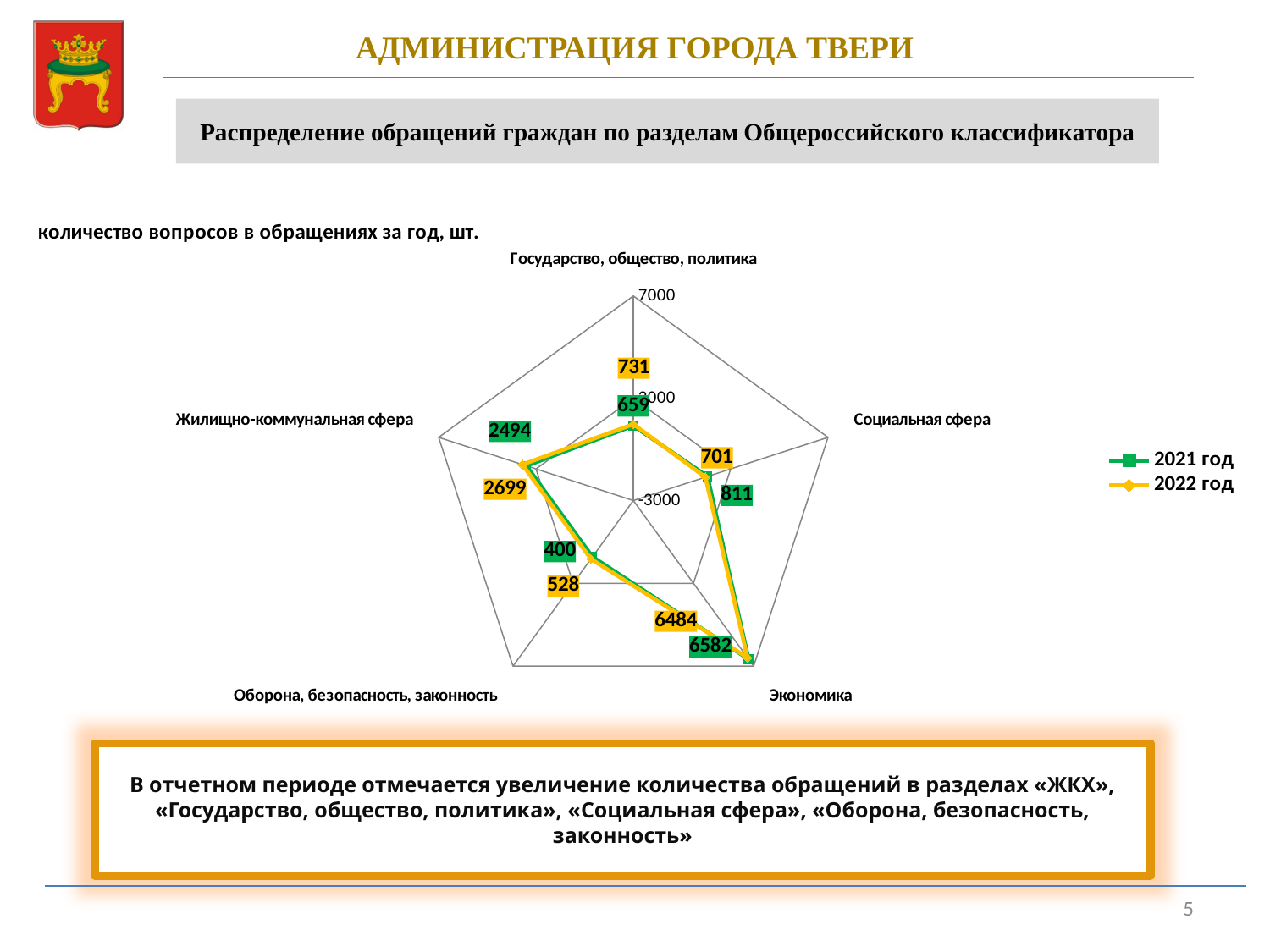
How many series does the legend list? 2 By how much did the value for Жилищно-коммунальная сфера increase from 2021 год to 2022 год? 205 For Экономика, which year has the larger value, 2021 год or 2022 год? 2021 год Which category has the lowest value for 2021 год? Оборона, безопасность, законность What is the value for Государство, общество, политика in 2022 год? 731 What is the value for Экономика in 2021 год? 6582 What is the maximum value shown on the radar chart's axis scale? 7000 What is the value for Жилищно-коммунальная сфера in 2022 год? 2699 Which category has the highest value for 2022 год? Экономика What is the value for Оборона, безопасность, законность in 2021 год? 400 What kind of chart is shown on the slide? radar chart How many categories (axes) does the radar chart have? 5